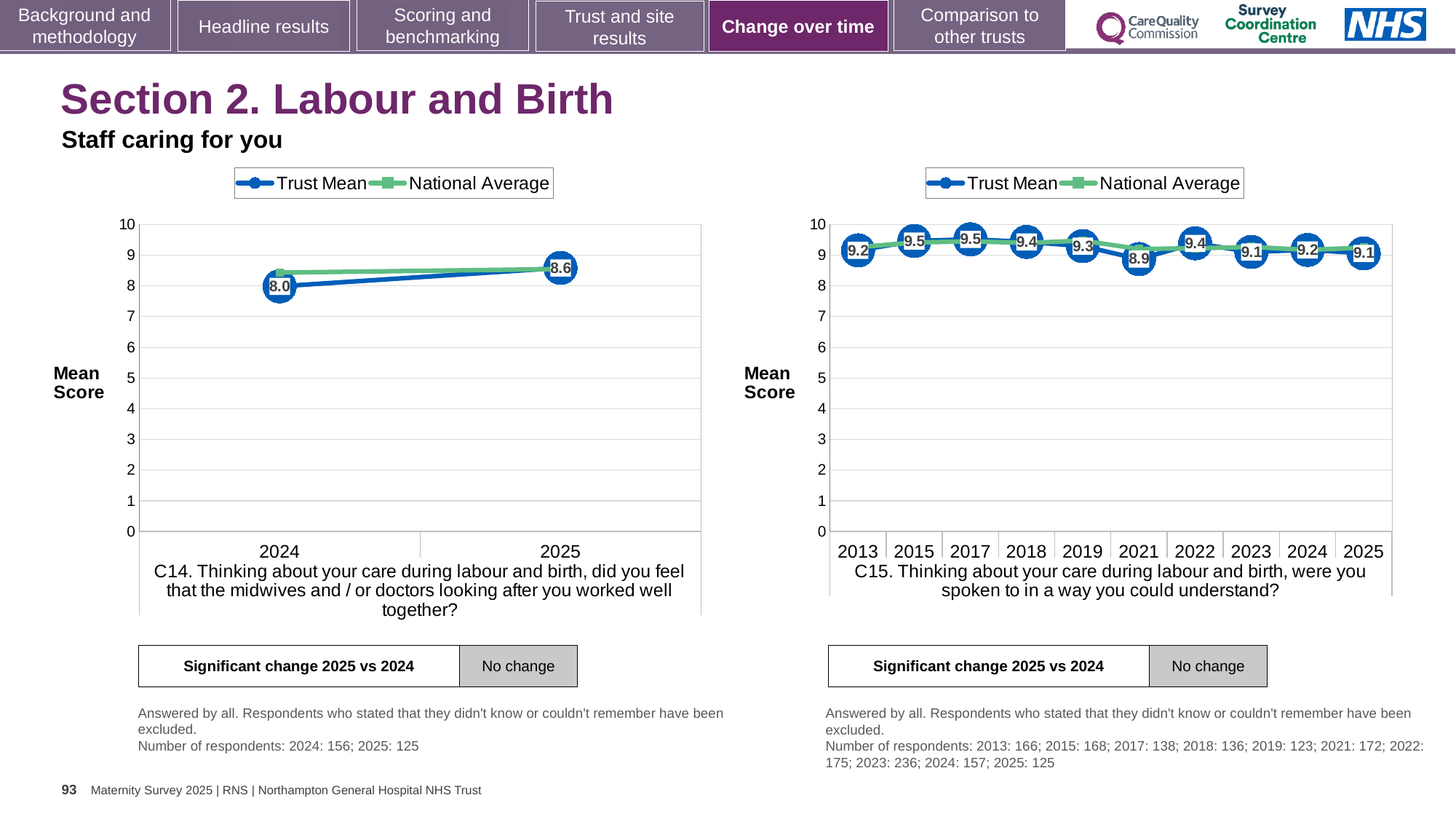
In the right chart (C15), what is the difference between the Trust Mean in 2017 and in 2021? 0.6 In the left chart (C14), does the Trust Mean rise or fall from 2024 to 2025? rise In the right chart (C15), how many years are plotted on the x axis? 10 In the left chart (C14), by how much did the Trust Mean change from 2024 to 2025? 0.6 In the right chart (C15), which year has the lowest Trust Mean score? 2021 How many series does the legend of the left chart list? 2 In the right chart (C15), is the Trust Mean for 2022 larger or smaller than for 2023? larger In the right chart (C15), what is the Trust Mean score for 2025? 9.1 In the left chart (C14), what is the Trust Mean score for 2025? 8.6 In the left chart (C14), what is the Trust Mean score for 2024? 8.0 What type of chart is used on the right side of the slide (C15)? line chart In the right chart (C15), what is the Trust Mean score for 2021? 8.9